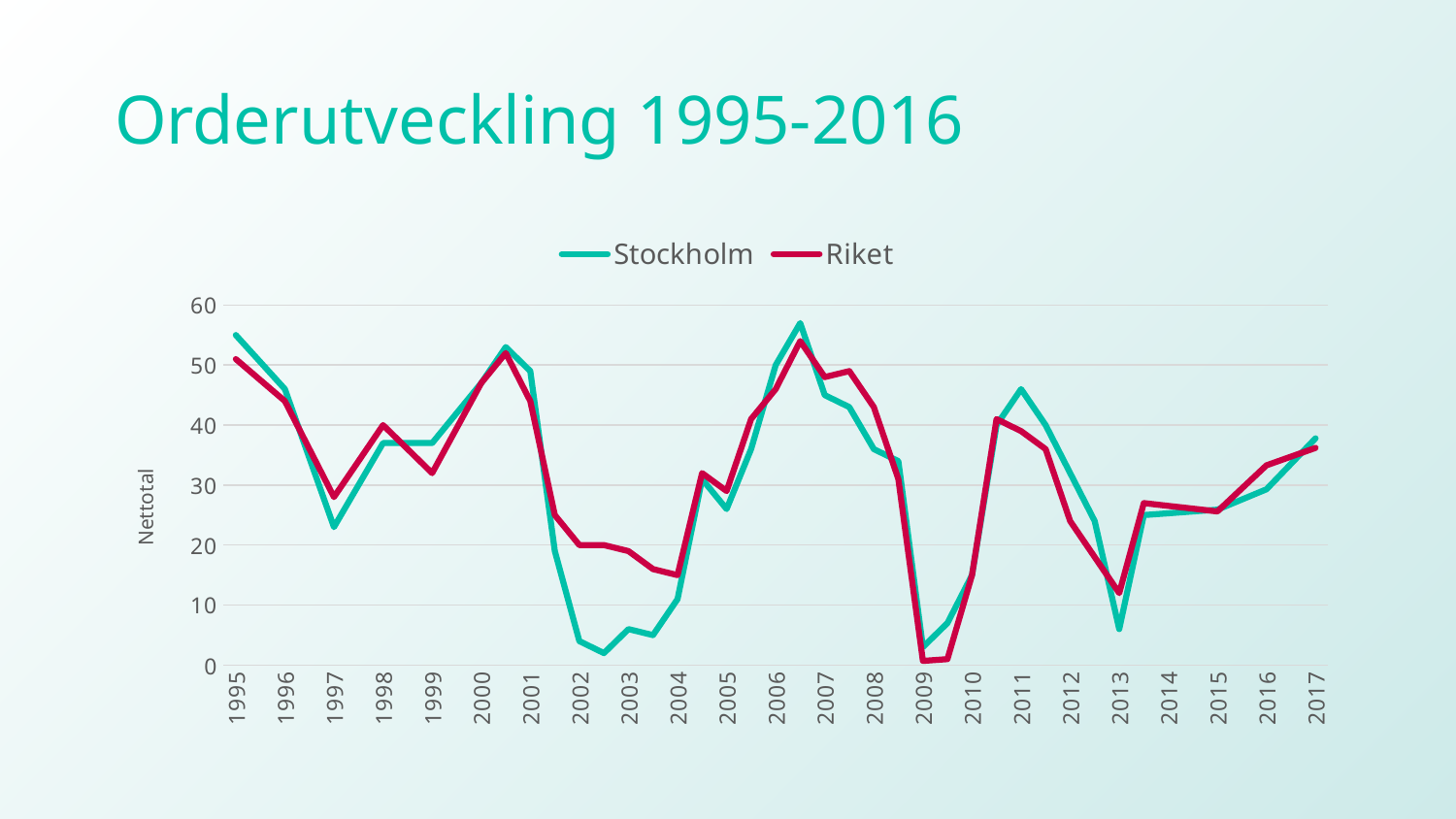
Is the value for Stockholm in 1995 greater or less than 50? greater In which year does the Riket series reach its lowest value? 2009 In 2011, which series has the higher value, Stockholm or Riket? Stockholm In 2002, which series has the higher value, Stockholm or Riket? Riket How many series does the legend list? 2 What is the label on the vertical axis? Nettotal Is the value for Riket in 2009 greater or less than 10? less Is the value for Stockholm in 2002 greater or less than 10? less Does the Stockholm series rise or fall between 2013 and 2017? rise What kind of chart is shown on the slide? line chart What is the title of the chart? Orderutveckling 1995-2016